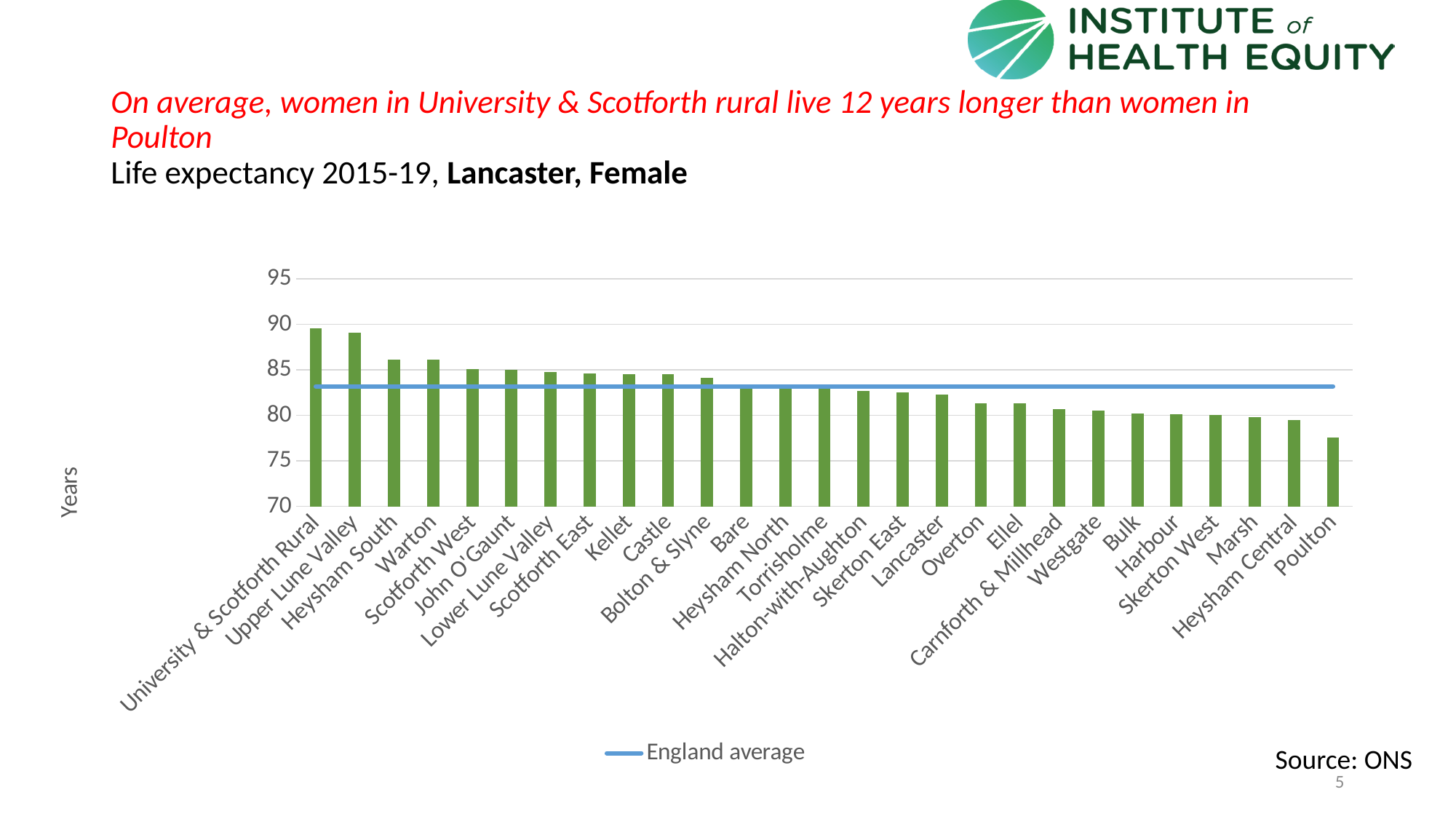
Is the value for Heysham South greater or less than 85? greater What does the blue horizontal line in the chart represent, according to the legend? England average Do the bar values rise or fall moving from left to right along the x axis? Fall Is the value for University & Scotforth Rural greater or less than 85? greater What kind of chart is shown on the slide? Bar chart Which has the higher female life expectancy, Warton or Marsh? Warton Is the value for Poulton greater or less than 80? less How many wards are plotted in the chart? 27 What is the label on the vertical axis of the chart? Years Which ward has the highest female life expectancy in the chart? University & Scotforth Rural Which ward has the lowest female life expectancy in the chart? Poulton